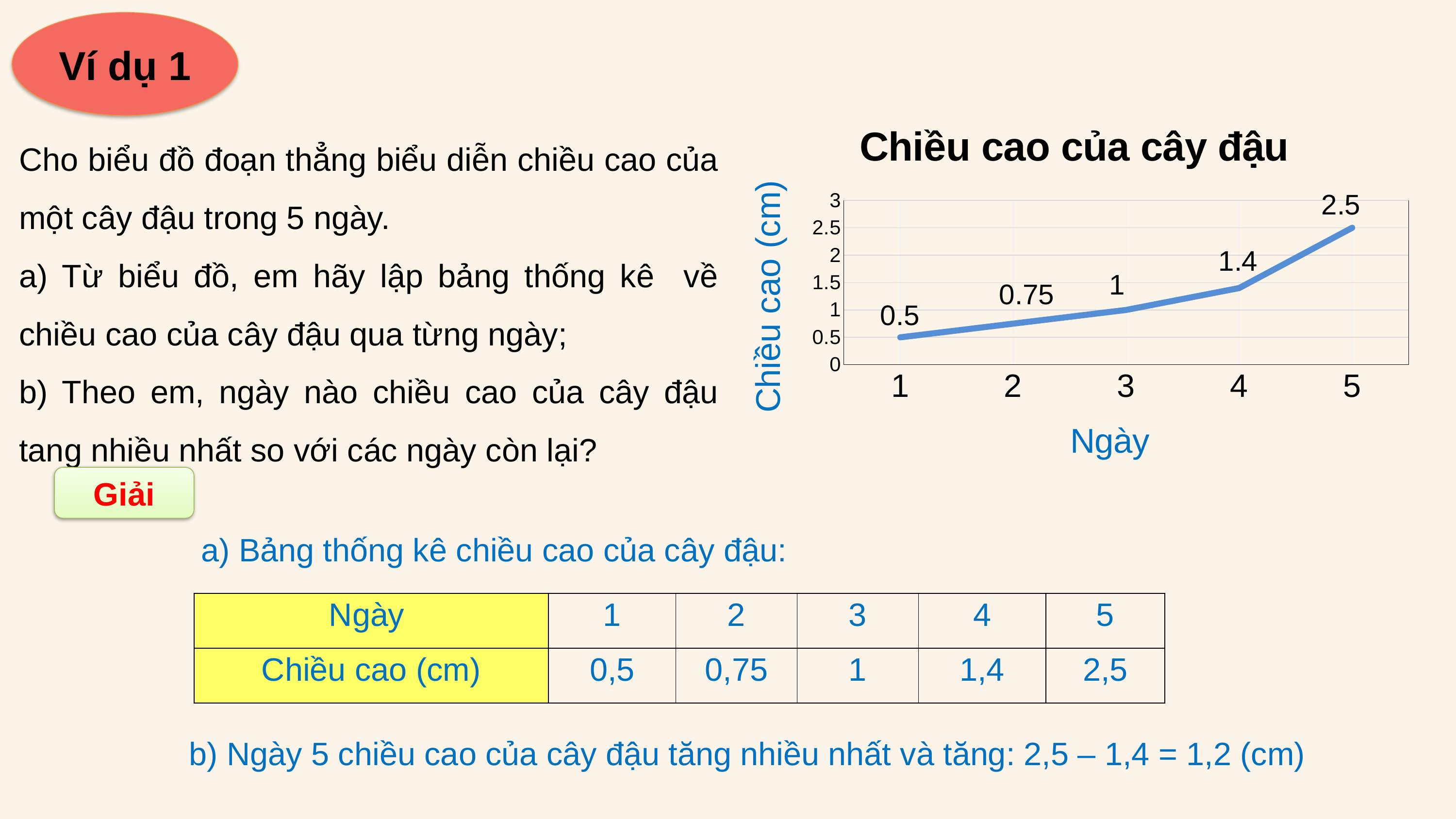
What kind of chart is shown on the slide? line chart How many days are plotted on the x axis of the chart? 5 On which day is the plant height lowest? 1 What is the difference between the values for day 3 and day 2? 0.25 Which is larger, the value for day 4 or the value for day 2? day 4 What is the plotted value for day 2? 0.75 On which day is the plant height highest? 5 Is the value for day 4 greater or less than 1.5? less What is the difference between the values for day 4 and day 1? 0.9 What is the height of the bean plant on day 3 in the chart 'Chiều cao của cây đậu'? 1 Do the values rise or fall from day 1 to day 5? rise What value is labelled for day 5 in the chart? 2.5